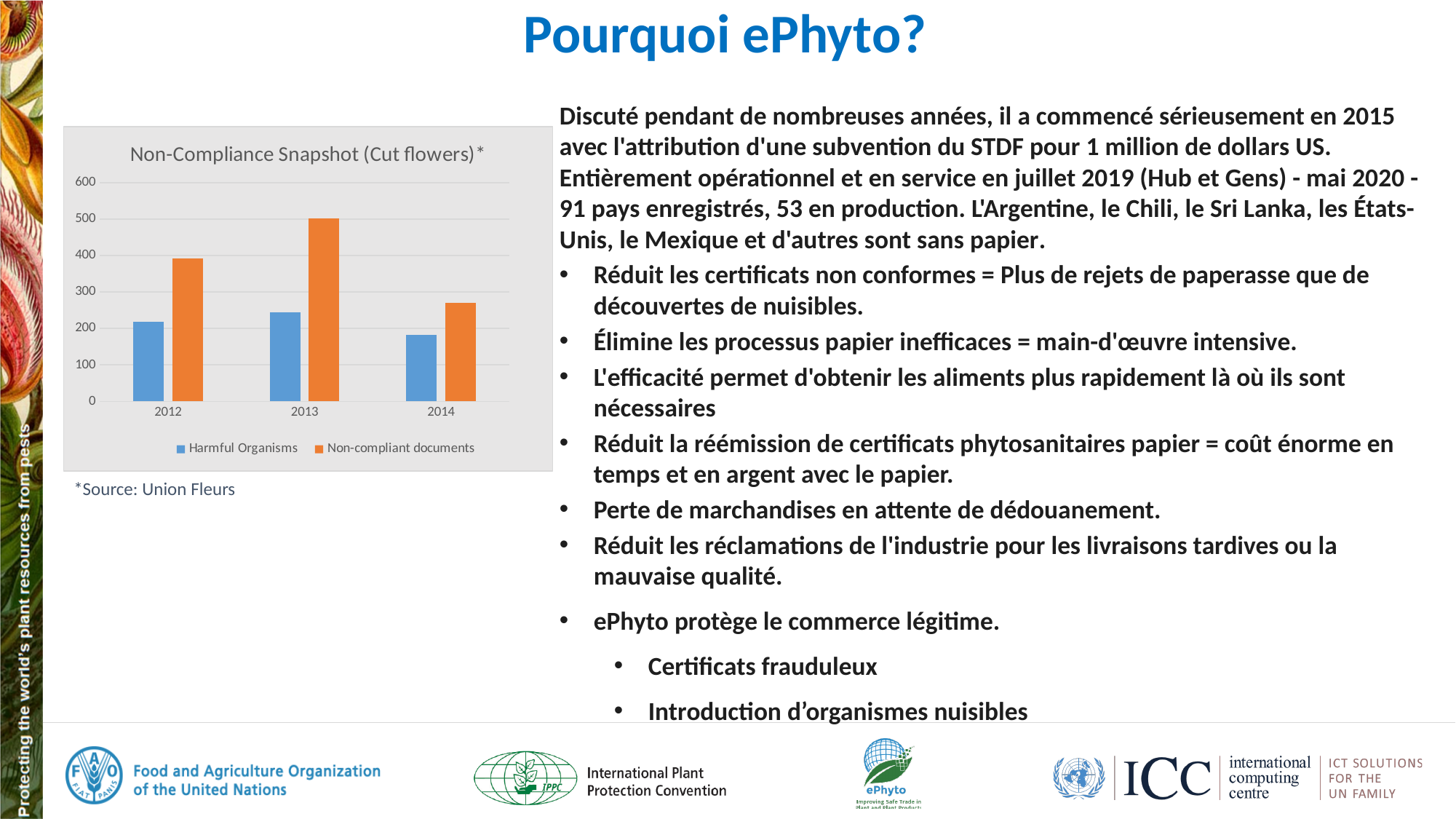
Which year has the lowest value for Harmful Organisms? 2014 Does the value for Non-compliant documents rise or fall from 2013 to 2014? Fall Which colour represents the Harmful Organisms series in the chart? Blue Is the value for Non-compliant documents in 2014 greater or less than 300? less Which year has the highest value for Non-compliant documents? 2013 Is the value for Non-compliant documents in 2013 greater or less than 400? greater How many series does the chart legend list? 2 What kind of chart is shown on the slide? Bar chart Is the value for Harmful Organisms in 2014 greater or less than 200? less How many years are shown on the x axis of the chart? 3 What is the title of the chart? Non-Compliance Snapshot (Cut flowers)* In 2012, which is larger: Harmful Organisms or Non-compliant documents? Non-compliant documents